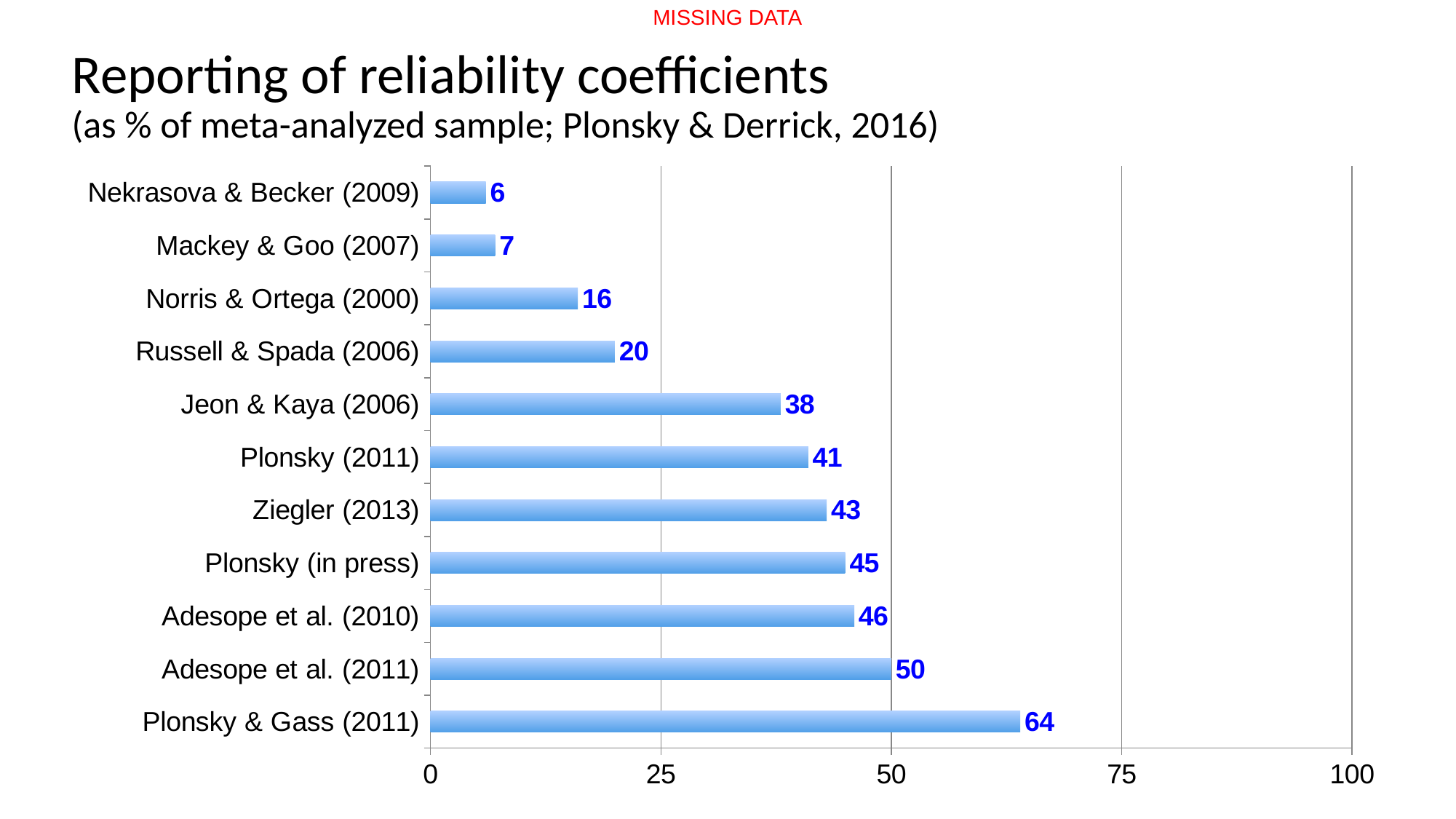
What kind of chart is shown on the slide? bar chart Which is larger, the value for Plonsky (2011) or the value for Jeon & Kaya (2006)? Plonsky (2011) What is the title of the chart? Reporting of reliability coefficients How many categories are shown in the chart? 11 Which category has the highest value? Plonsky & Gass (2011) What is the value for Plonsky & Gass (2011)? 64 Is the value for Adesope et al. (2010) greater or less than 50? less What is the value for Ziegler (2013)? 43 What is the value for Norris & Ortega (2000)? 16 Which category has the lowest value? Nekrasova & Becker (2009) What is the difference between the values for Jeon & Kaya (2006) and Russell & Spada (2006)? 18 What is the difference between the values for Plonsky & Gass (2011) and Adesope et al. (2011)? 14